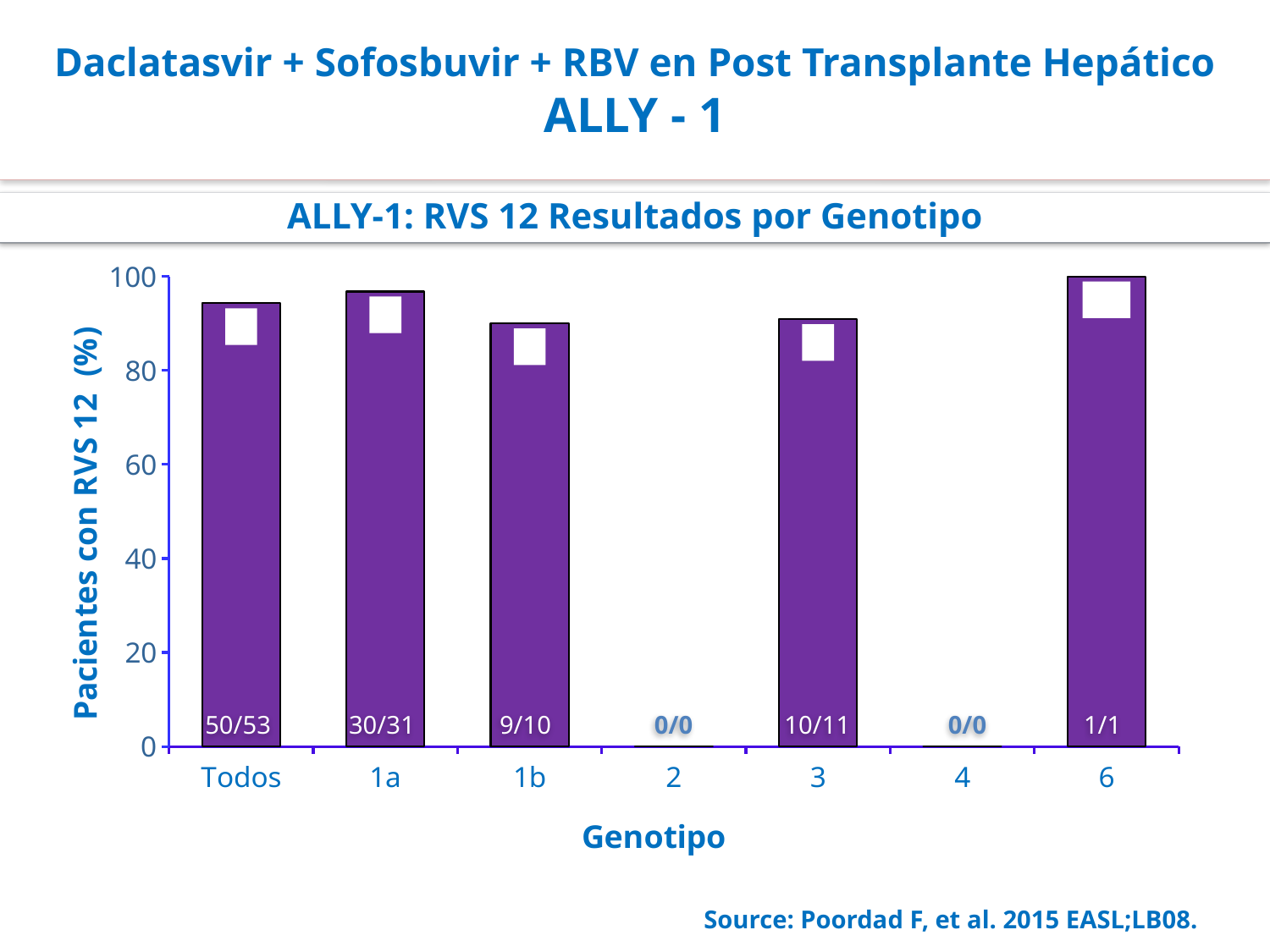
Is the value for genotype 1b greater or less than 80? greater Which has a higher RVS 12 percentage, genotype 1a or genotype 1b? 1a What fraction label is printed on the bar for genotype 1a? 30/31 What fraction label is printed on the bar for genotype 3? 10/11 What fraction label is printed on the bar for Todos? 50/53 Which genotype has the highest RVS 12 percentage? 6 What kind of chart is shown on the slide? bar chart What is the RVS 12 percentage for genotype 6? 100 How many genotype categories are shown on the x axis? 7 What is the title of the chart? ALLY-1: RVS 12 Resultados por Genotipo What label is shown for genotype 2? 0/0 What is the label of the y axis? Pacientes con RVS 12 (%)